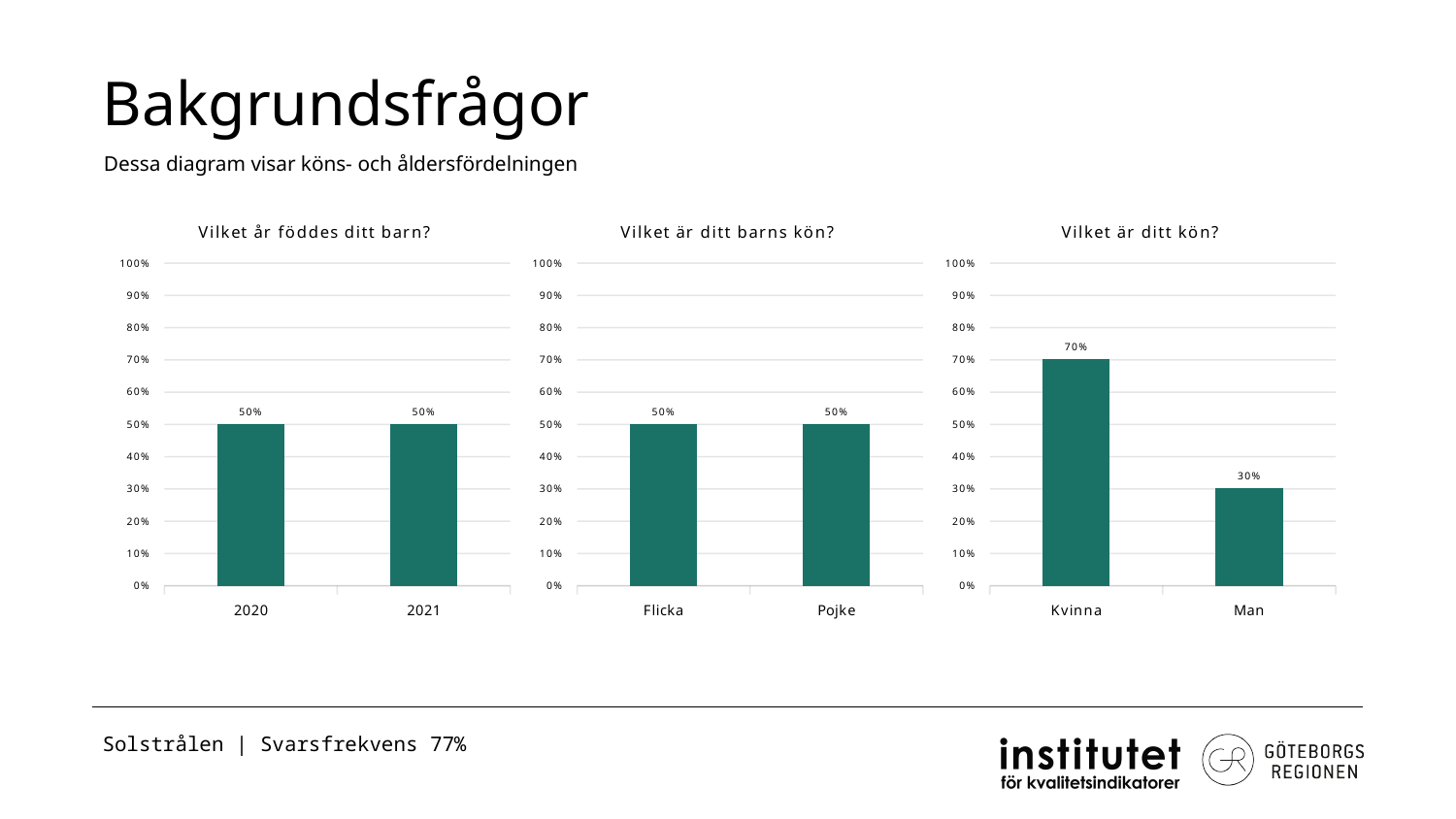
In the chart titled "Vilket år föddes ditt barn?", what is the value for 2021? 50% What kind of chart is the chart titled "Vilket är ditt barns kön?"? Bar chart In the chart titled "Vilket är ditt kön?", which category has the highest value? Kvinna How many categories are shown in the chart titled "Vilket år föddes ditt barn?"? 2 In the chart titled "Vilket år föddes ditt barn?", what is the value for 2020? 50% In the chart titled "Vilket är ditt barns kön?", what is the value for Pojke? 50% In the chart titled "Vilket är ditt kön?", what is the value for Kvinna? 70% In the chart titled "Vilket är ditt barns kön?", what is the value for Flicka? 50% In the chart titled "Vilket är ditt kön?", is the value for Kvinna greater or less than 60%? greater In the chart titled "Vilket är ditt kön?", which category has the lowest value? Man In the chart titled "Vilket är ditt kön?", what is the value for Man? 30% In the chart titled "Vilket är ditt kön?", what is the difference between the values for Kvinna and Man? 40%